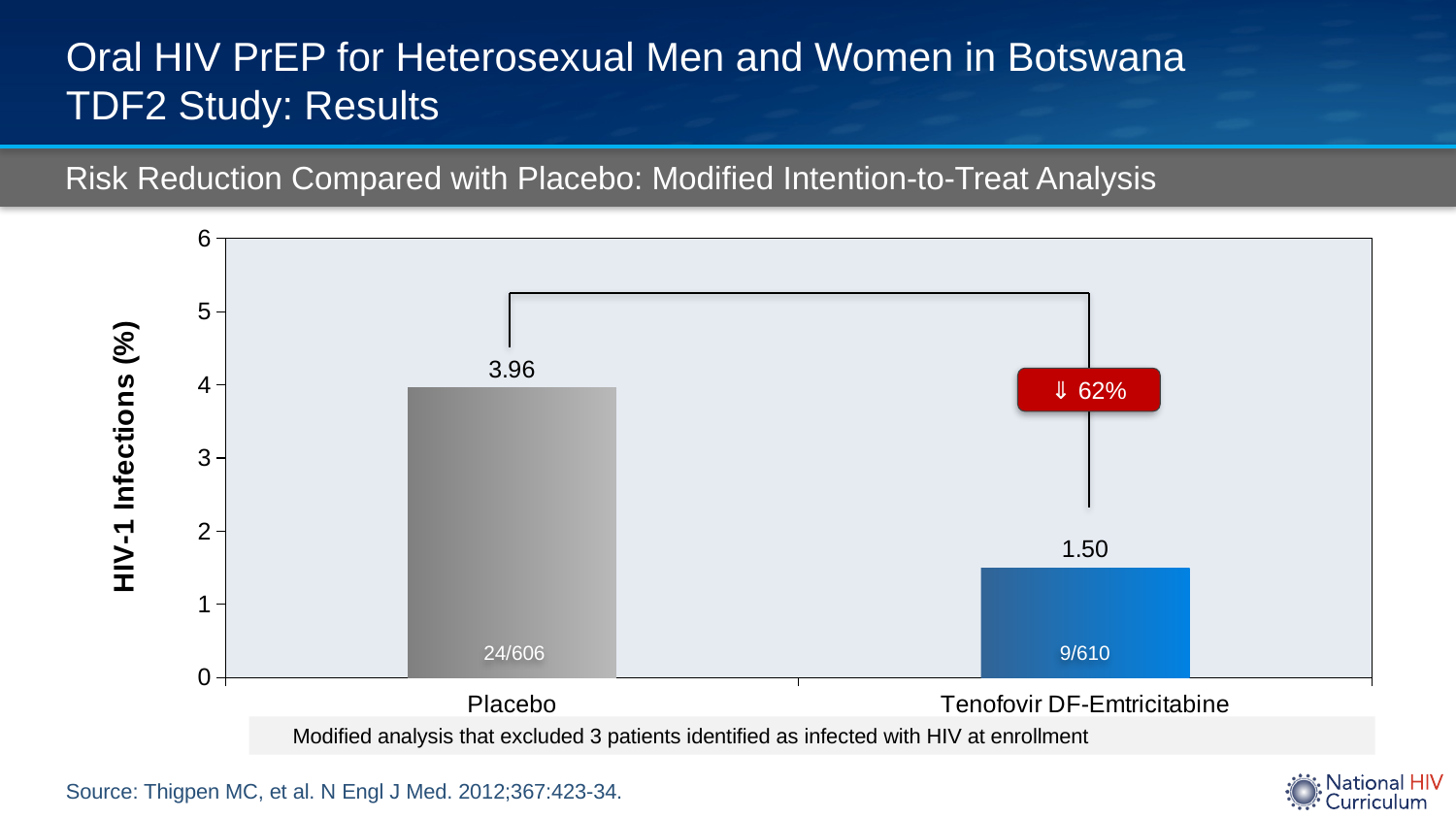
Is the HIV-1 infection rate for Tenofovir DF-Emtricitabine greater or less than 2? less Which group has the higher HIV-1 infection rate? Placebo How many infections out of how many participants are shown for the Tenofovir DF-Emtricitabine bar? 9/610 What kind of chart is shown on the slide? Bar chart What percentage risk reduction is shown in the red box on the chart? 62% What is the HIV-1 infection rate (%) for the Placebo group? 3.96 What is the difference in HIV-1 infection rate (%) between the Placebo and Tenofovir DF-Emtricitabine groups? 2.46 Is the HIV-1 infection rate for Placebo greater or less than 3? greater How many groups are shown on the chart? 2 How many infections out of how many participants are shown for the Placebo bar? 24/606 What is the HIV-1 infection rate (%) for the Tenofovir DF-Emtricitabine group? 1.50 Which group has the lower HIV-1 infection rate? Tenofovir DF-Emtricitabine